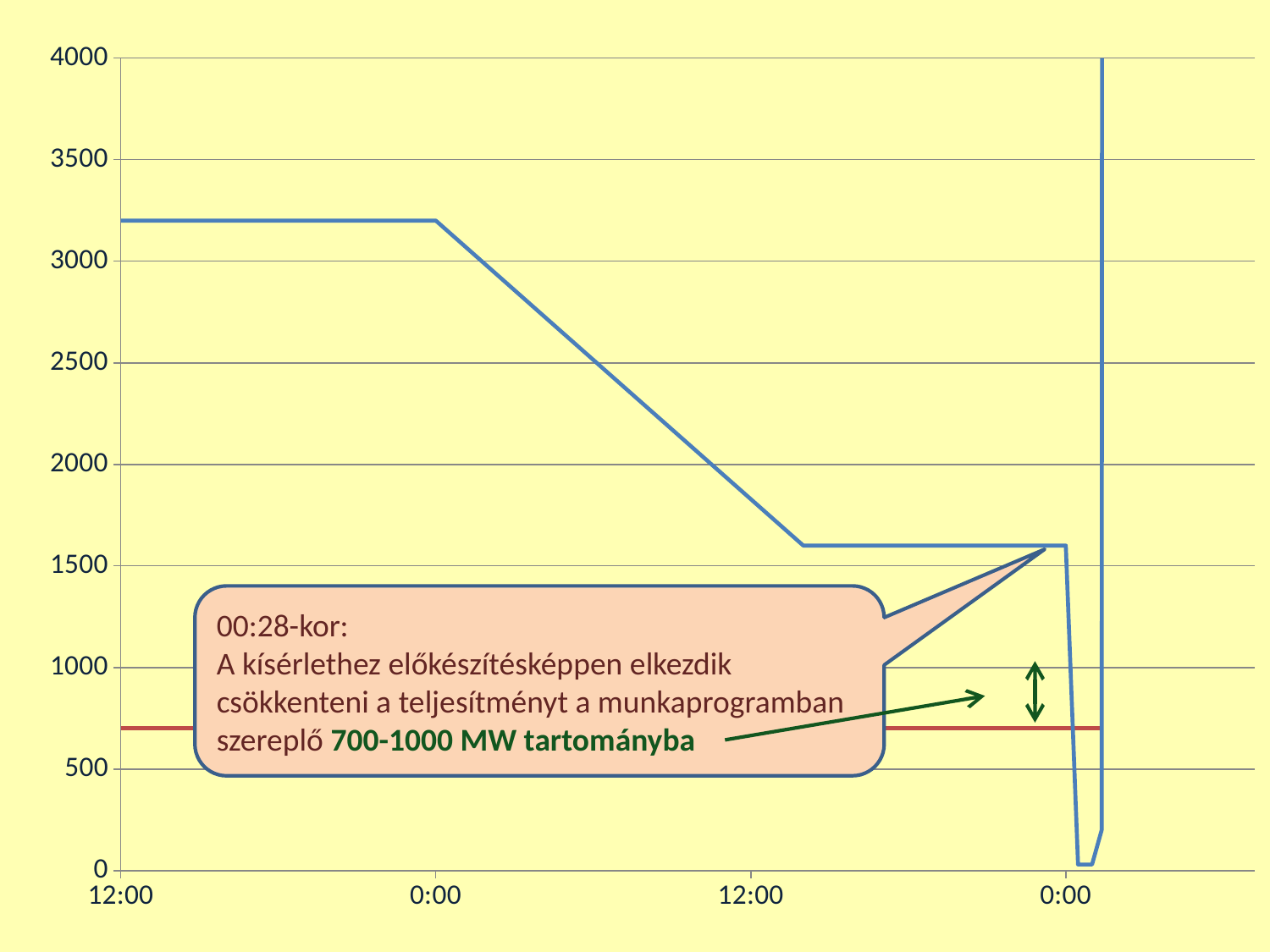
Is the value of the blue line at the second 12:00 tick greater or less than 2000? less How many time labels are shown on the x axis? 4 What power range does the callout box say the output is reduced to? 700-1000 MW Which is larger: the blue line's value at the leftmost 12:00 tick or at the second 12:00 tick? the leftmost 12:00 tick Does the blue line rise or fall between the 0:00 and the second 12:00 tick on the x axis? fall What kind of chart is shown on the slide? line chart Is the value of the blue line at the second 12:00 tick greater or less than 1500? greater Is the red horizontal line above or below the 1000 gridline? below What time is mentioned at the start of the callout box? 00:28